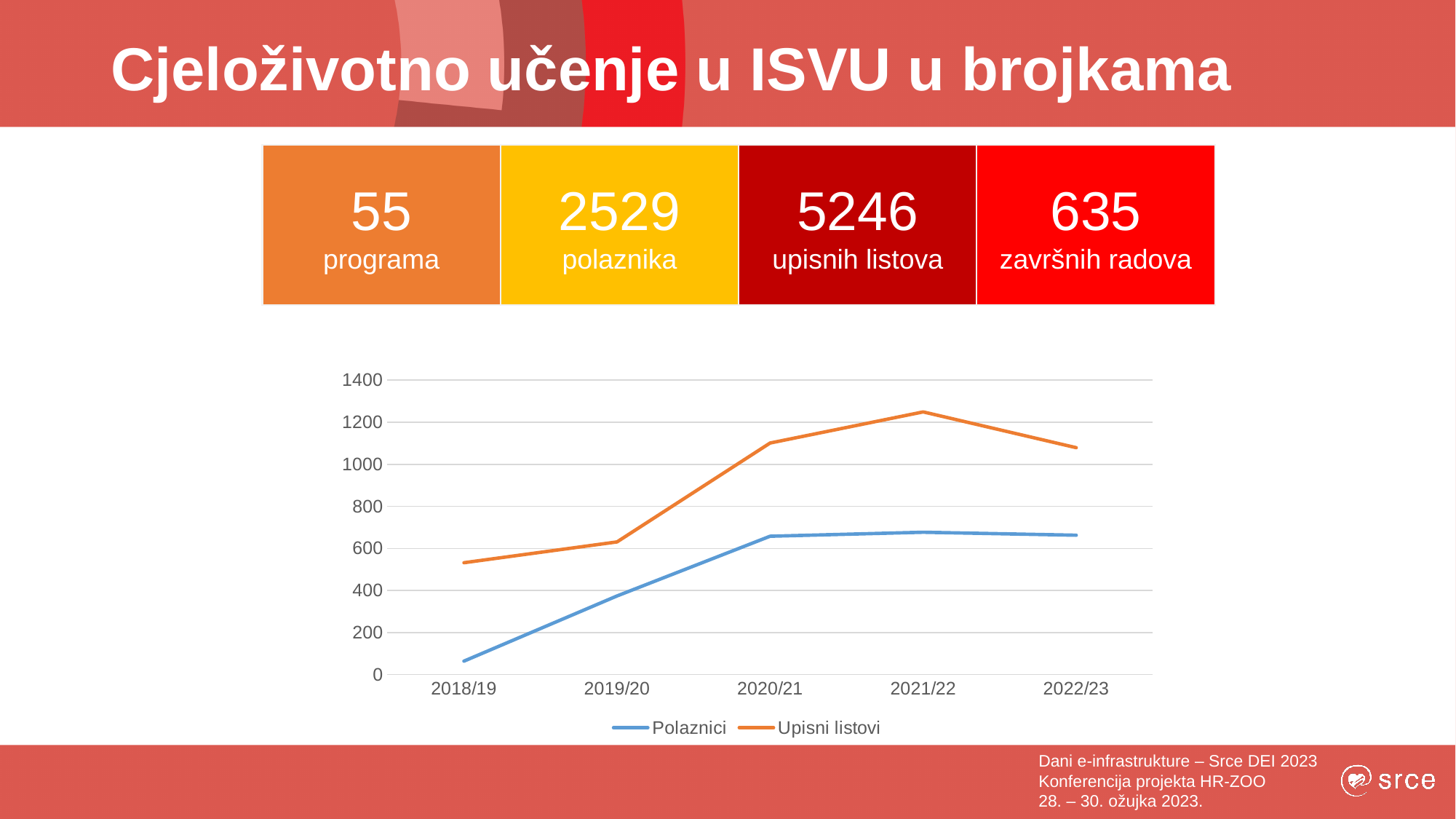
Is the value for Upisni listovi in 2021/22 greater or less than 1200? greater Which series has the larger value in 2022/23, Polaznici or Upisni listovi? Upisni listovi Is the value for Polaznici in 2018/19 greater or less than 200? less Is the value for Polaznici in 2019/20 greater or less than 600? less What kind of chart is shown on the slide? line chart Does the Polaznici series rise or fall from 2018/19 to 2020/21? rise Which series is drawn in orange in the chart? Upisni listovi How many series does the chart's legend list? 2 How many academic years are shown on the x axis of the chart? 5 In which academic year is the Polaznici series at its lowest? 2018/19 In which academic year does the Upisni listovi series reach its highest value? 2021/22